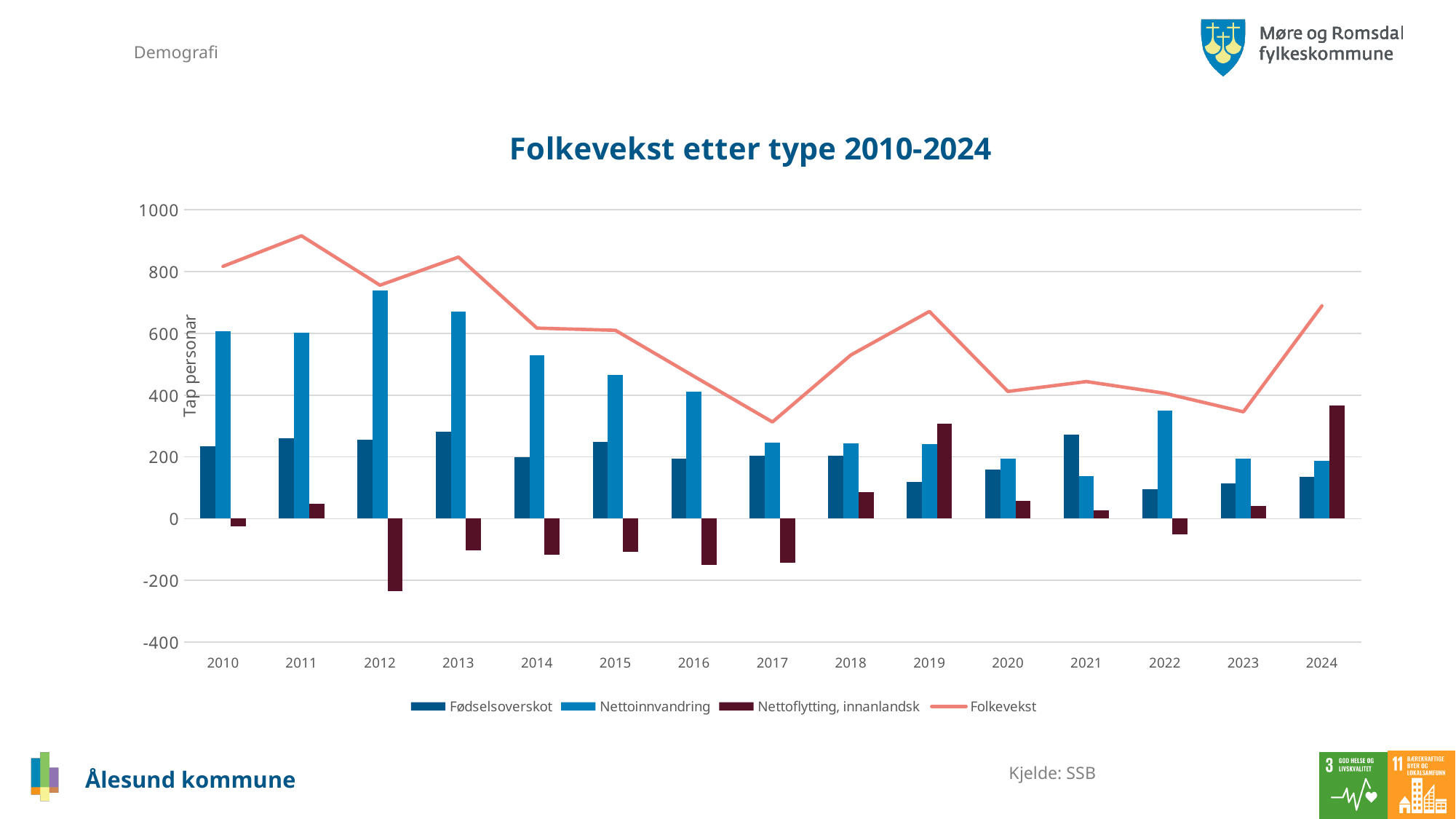
In which year does the Folkevekst line reach its highest point? 2011 In which year is Nettoflytting, innanlandsk lowest? 2012 In which year is Nettoinnvandring highest? 2012 How many years are shown on the x axis? 15 Is the value for Folkevekst in 2017 greater or less than 400? less In which year does the Folkevekst line reach its lowest point? 2017 Is the value for Nettoinnvandring in 2012 greater or less than 600? greater What kind of chart is shown on the slide? A combined bar and line chart Does Nettoinnvandring rise or fall from 2012 to 2021? fall Which is larger in 2021, Fødselsoverskot or Nettoinnvandring? Fødselsoverskot In which year is Nettoflytting, innanlandsk highest? 2024 How many series does the legend list? 4